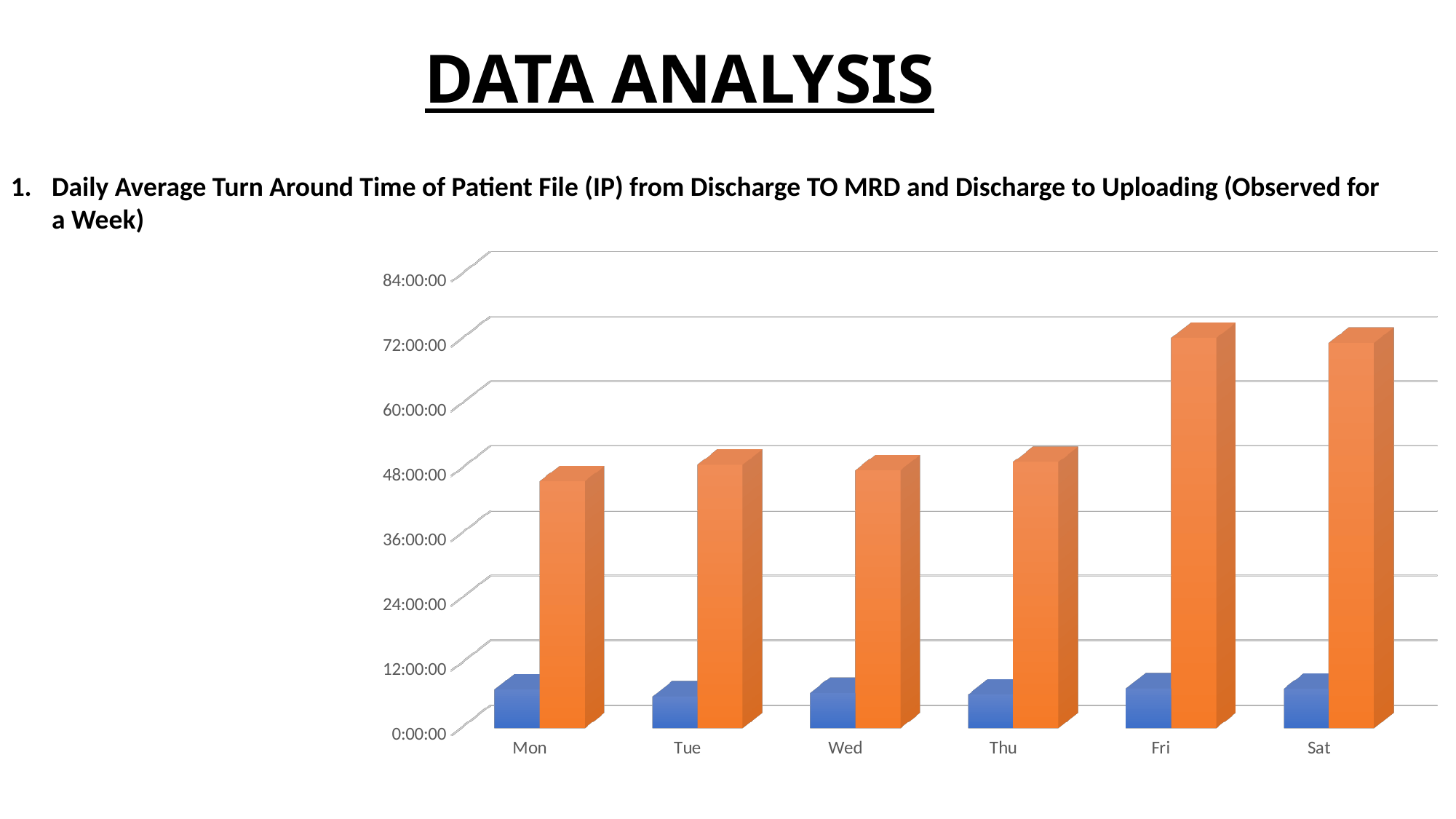
Is the value of the orange bar for Sat greater or less than 60:00:00? greater Which day has the lowest orange bar? Mon Is the value of the orange bar for Tue greater or less than 60:00:00? less Is the value of the orange bar for Mon greater or less than 36:00:00? greater What kind of chart is shown on the slide? Bar chart Which is larger, the orange bar for Fri or the orange bar for Wed? Fri How many data series are plotted in the chart? 2 How many days (categories) are shown on the x axis of the chart? 6 What is the first day listed on the x axis of the chart? Mon On Mon, which bar is taller, the blue one or the orange one? The orange one